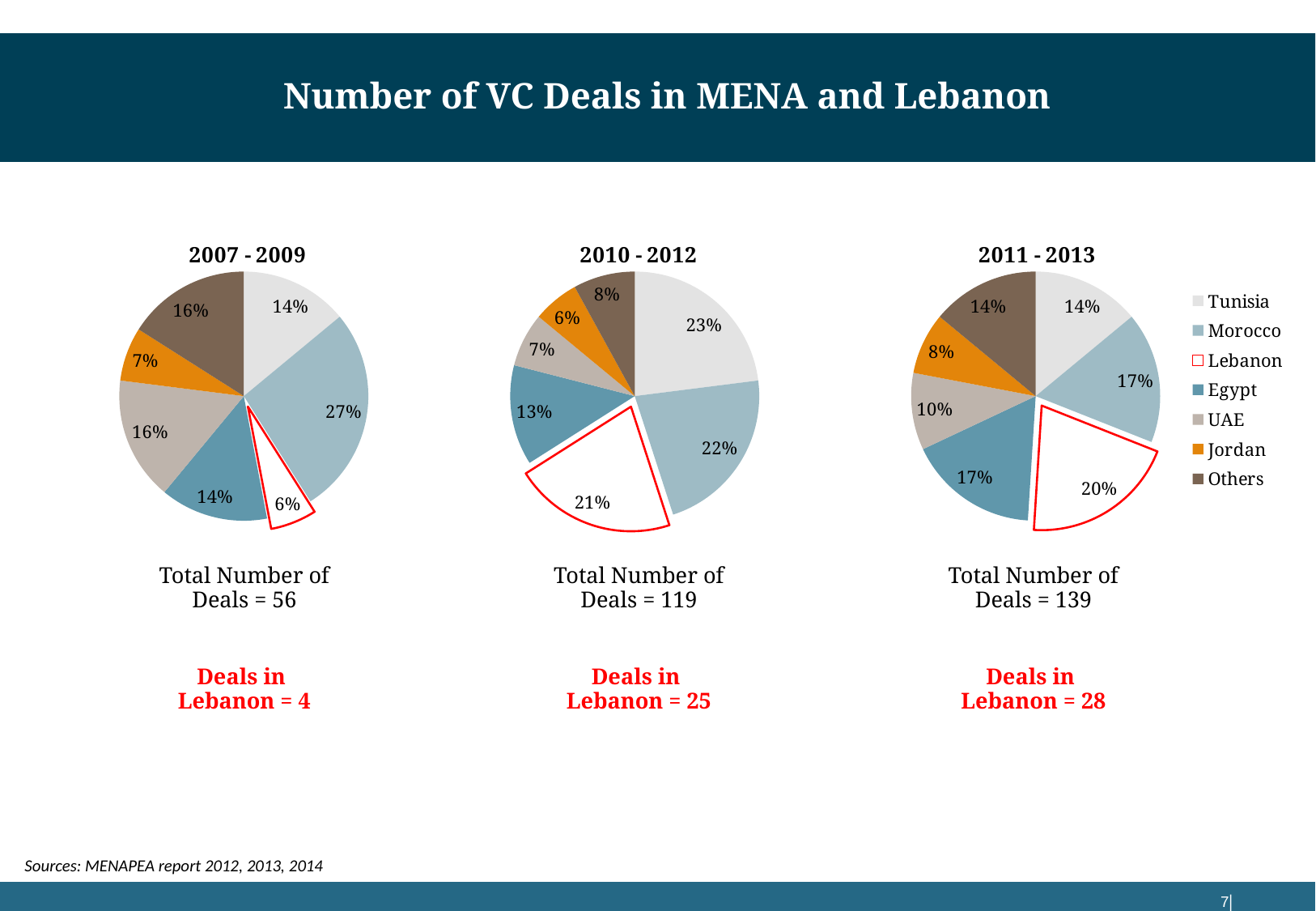
How many categories does the legend list for the pie charts? 7 In the 2010 - 2012 pie chart, what share of deals does Lebanon have? 21% In the 2011 - 2013 pie chart, what is the difference in percentage points between Lebanon's share and UAE's share? 10 In the 2010 - 2012 pie chart, which has a larger share, Egypt or UAE? Egypt In the 2007 - 2009 pie chart, which country has the largest share of deals? Morocco In the 2011 - 2013 pie chart, what share of deals does Egypt have? 17% According to the text under the 2011 - 2013 pie chart, what is the total number of deals? 139 What kind of chart is used to show the 2010 - 2012 deal distribution? Pie chart In the 2007 - 2009 pie chart, which category has the smallest share? Lebanon In the 2011 - 2013 pie chart, which country has the largest share of deals? Lebanon In the 2010 - 2012 pie chart, which category has the smallest share? Jordan In the 2007 - 2009 pie chart, what share of deals does Morocco have? 27%